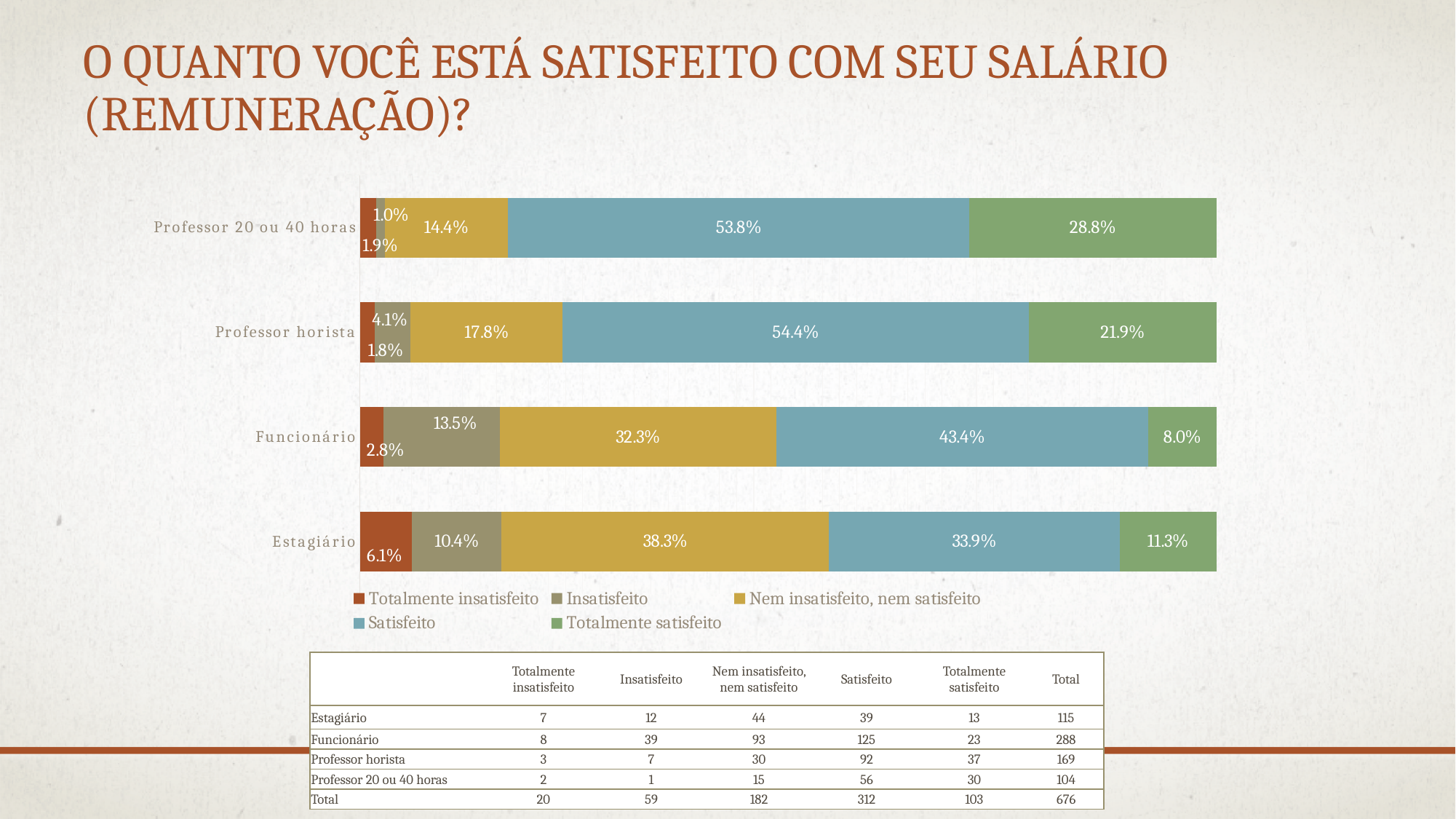
Which is larger: the 'Insatisfeito' value for Funcionário or for Estagiário? Funcionário Which legend entry is shown in green? Totalmente satisfeito What kind of chart is shown on the slide? stacked bar chart Which category has the lowest 'Satisfeito' share? Estagiário How many series does the chart legend list? 5 What is the difference between the 'Satisfeito' values for Professor horista and Funcionário? 11.0% How many categories (job groups) are plotted in the chart? 4 What is the 'Totalmente insatisfeito' value for Estagiário? 6.1% What is the 'Totalmente satisfeito' value for Funcionário? 8.0% What is the 'Nem insatisfeito, nem satisfeito' value for Estagiário? 38.3% What is the 'Satisfeito' value for Professor horista? 54.4% Which category has the highest 'Totalmente satisfeito' share? Professor 20 ou 40 horas